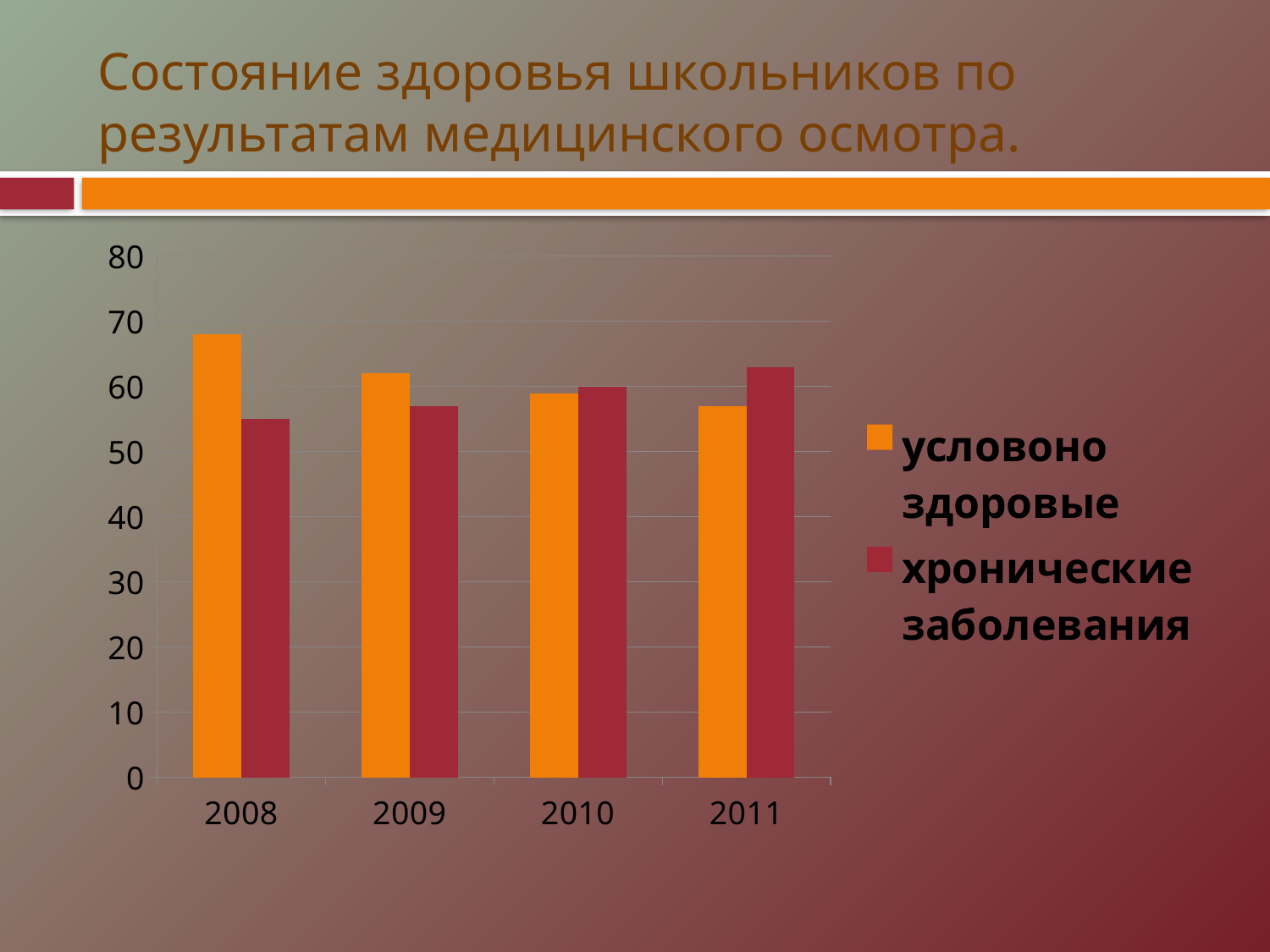
How many series does the legend list? 2 Is the value for хронические заболевания in 2008 greater or less than 60? less In 2011, which series has the larger value, условоно здоровые or хронические заболевания? хронические заболевания Is the value for условоно здоровые in 2008 greater or less than 60? greater In which year is the value for хронические заболевания lowest? 2008 In which year is the value for условоно здоровые lowest? 2011 What kind of chart is shown on the slide? bar chart Do the values for условоно здоровые rise or fall from 2008 to 2011? fall How many years are shown on the x axis? 4 In which year is the value for хронические заболевания highest? 2011 In which year is the value for условоно здоровые highest? 2008 Which series is shown in orange? условоно здоровые